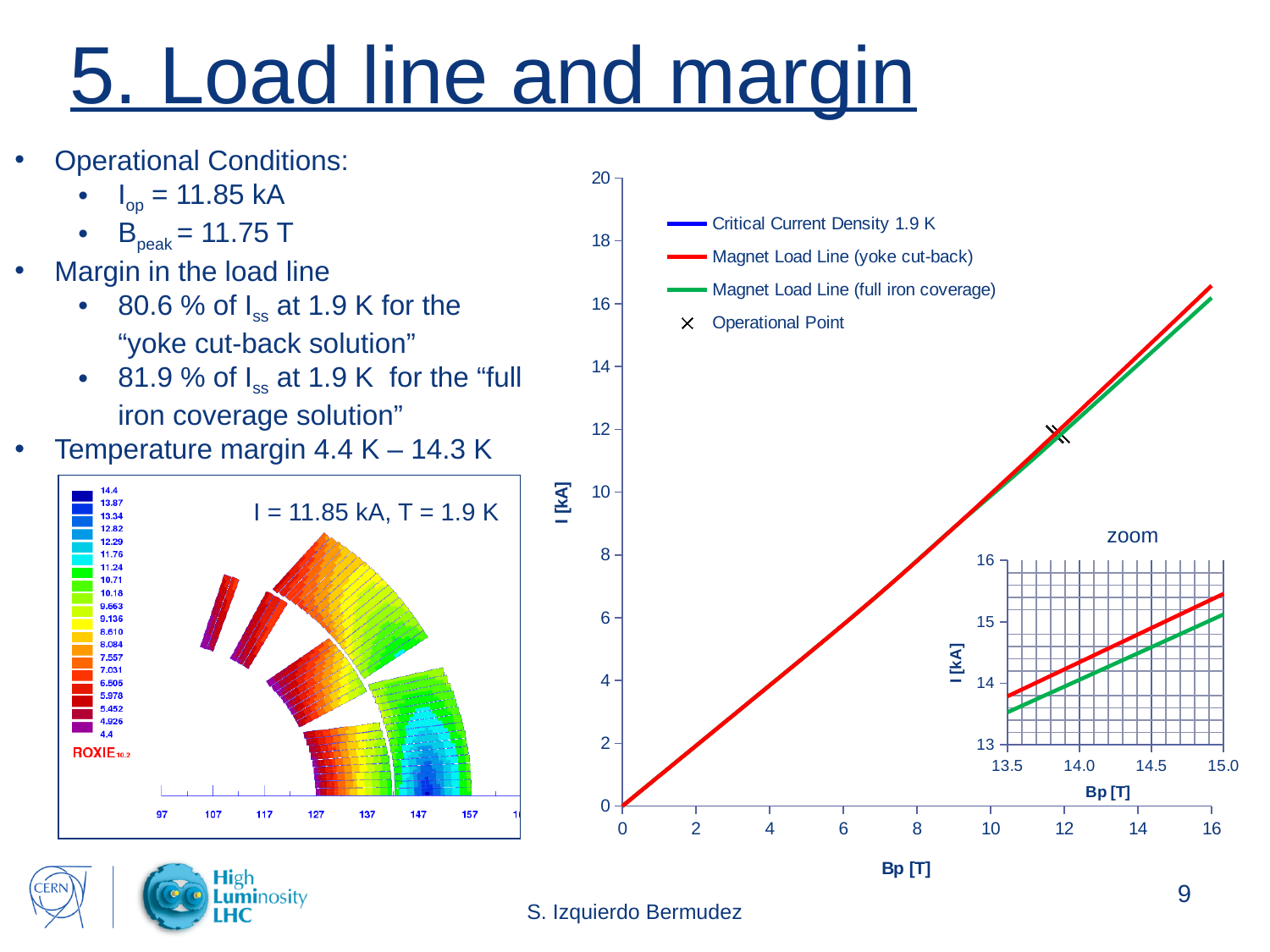
In the zoom chart, is the red 'yoke cut-back' load line at Bp = 15.0 T greater or less than 15 kA? greater In the main load line chart, is the current of the Operational Point greater or less than 10 kA? greater What is the label of the x axis of the main load line chart? Bp [T] What is the highest value shown on the x axis of the zoom chart? 15.0 In the main load line chart, what colour is the 'Magnet Load Line (full iron coverage)' series? green According to the slide, what is the current at the Operational Point marked on the load line chart? 11.85 kA In the zoom chart, at Bp = 15.0 T, which line is higher: the red 'yoke cut-back' load line or the green 'full iron coverage' load line? red (yoke cut-back) In the zoom chart, is the green 'full iron coverage' load line at Bp = 13.5 T greater or less than 14 kA? less What is the highest value shown on the y axis of the main load line chart? 20 How many entries does the legend of the main load line chart list? 4 In the main load line chart, do the load lines rise or fall as Bp increases? rise What kind of chart is the large chart on the right of the slide? line chart